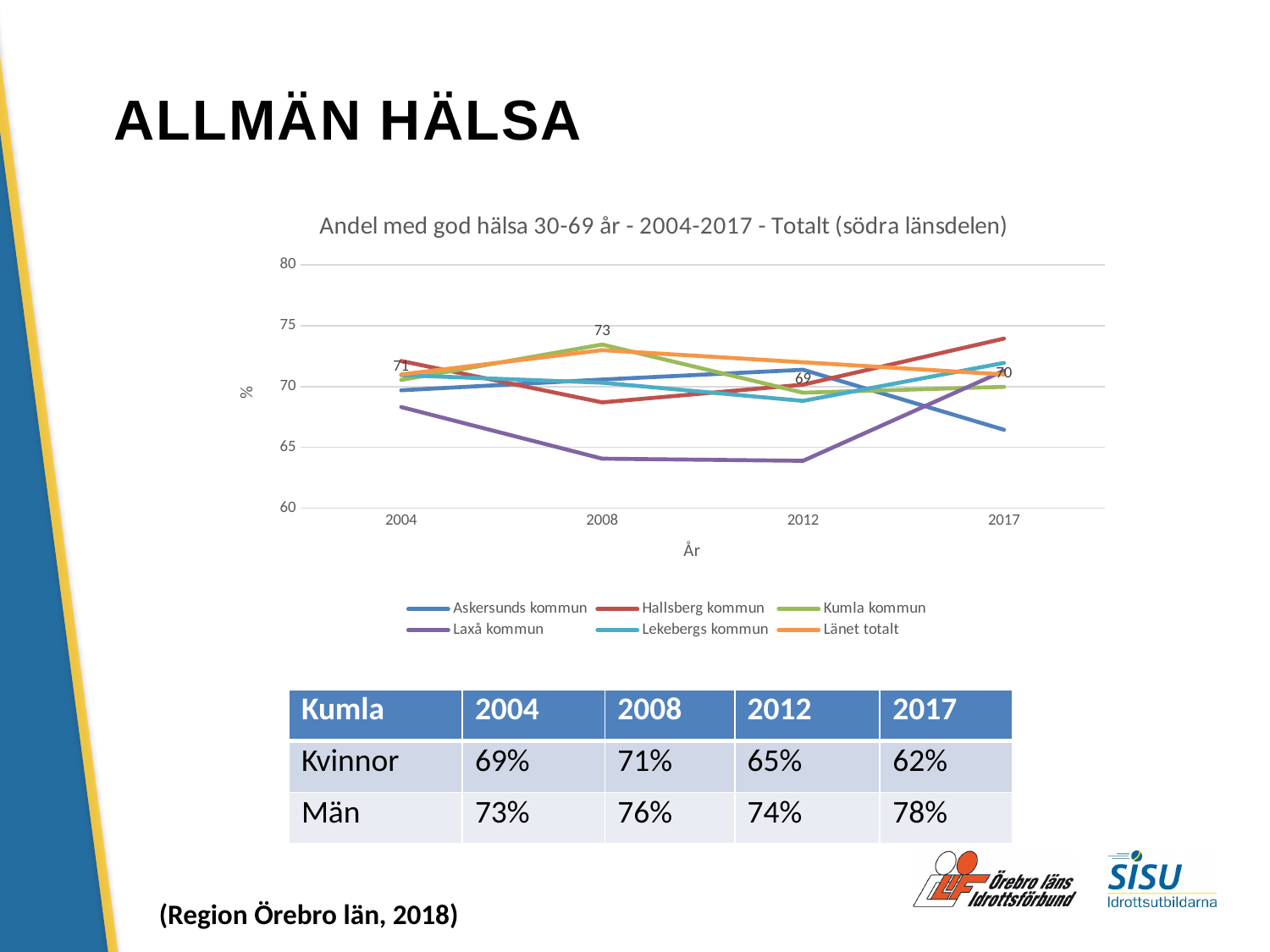
How many series does the chart legend list? 6 How many years are plotted along the x axis of the chart? 4 What kind of chart is shown on the slide? line chart What value is labelled on the chart for Kumla kommun in 2012? 69 What value is labelled on the chart for Kumla kommun in 2008? 73 What is the title of the chart? Andel med god hälsa 30-69 år - 2004-2017 - Totalt (södra länsdelen) Is the value for Laxå kommun in 2008 greater or less than 65? less In 2012, which is larger: Laxå kommun or Länet totalt? Länet totalt Is the value for Askersunds kommun in 2017 greater or less than 70? less In which year does Kumla kommun reach its highest labelled value? 2008 In which year does Kumla kommun have its lowest labelled value? 2012 What is the difference between the labelled values for Kumla kommun in 2008 and 2012? 4